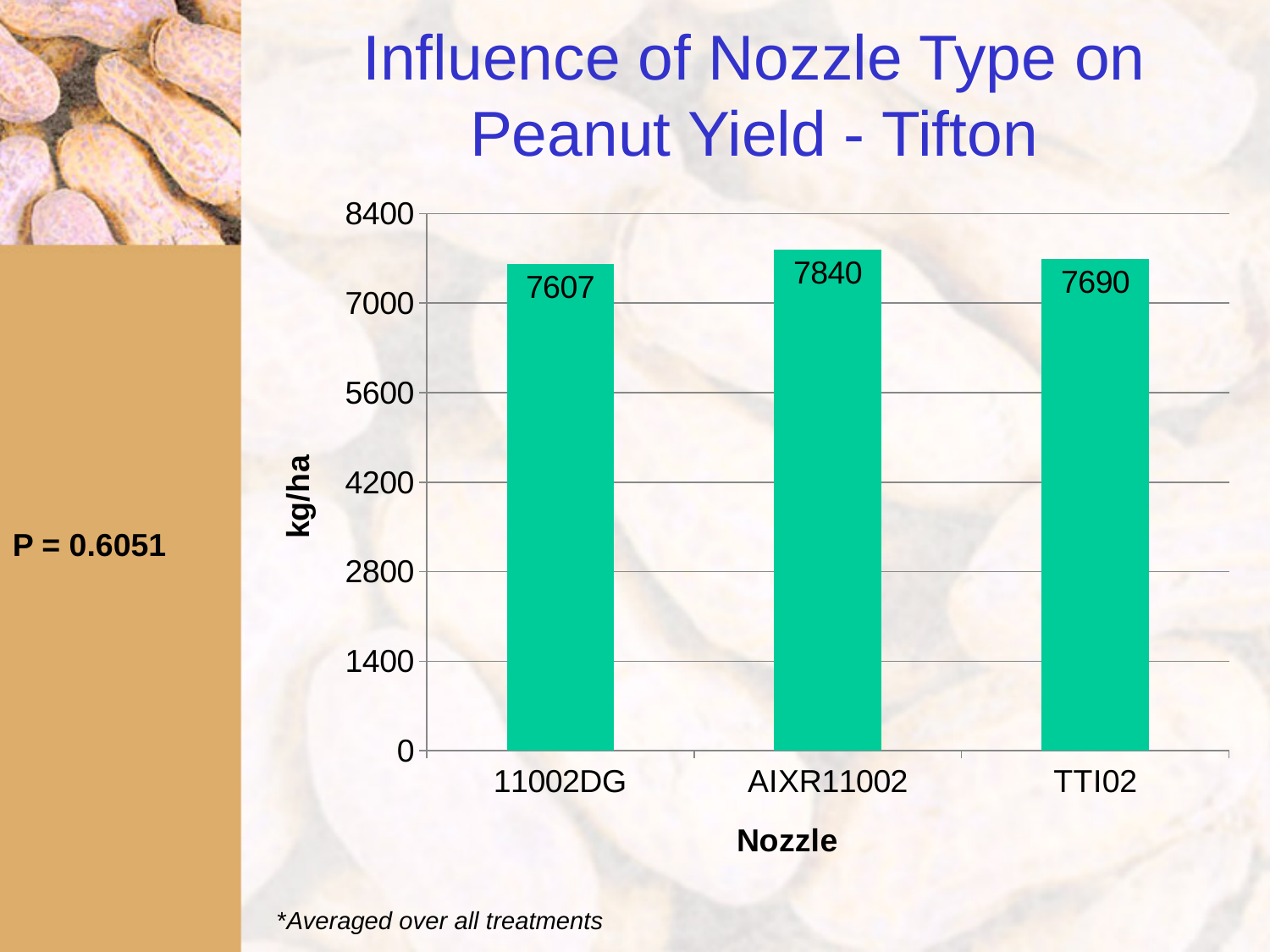
Which nozzle type has the lowest peanut yield? 11002DG What is the peanut yield for the AIXR11002 nozzle? 7840 What is the difference in yield between the TTI02 and 11002DG nozzles? 83 Is the yield for 11002DG greater or less than 7000? greater What is the peanut yield for the TTI02 nozzle? 7690 How many nozzle types are shown in the chart? 3 Which has a higher yield, AIXR11002 or TTI02? AIXR11002 What type of chart is shown on the slide? bar chart What is the difference in yield between the AIXR11002 and 11002DG nozzles? 233 What is the peanut yield for the 11002DG nozzle? 7607 What unit is shown on the y-axis of the chart? kg/ha Which nozzle type has the highest peanut yield? AIXR11002